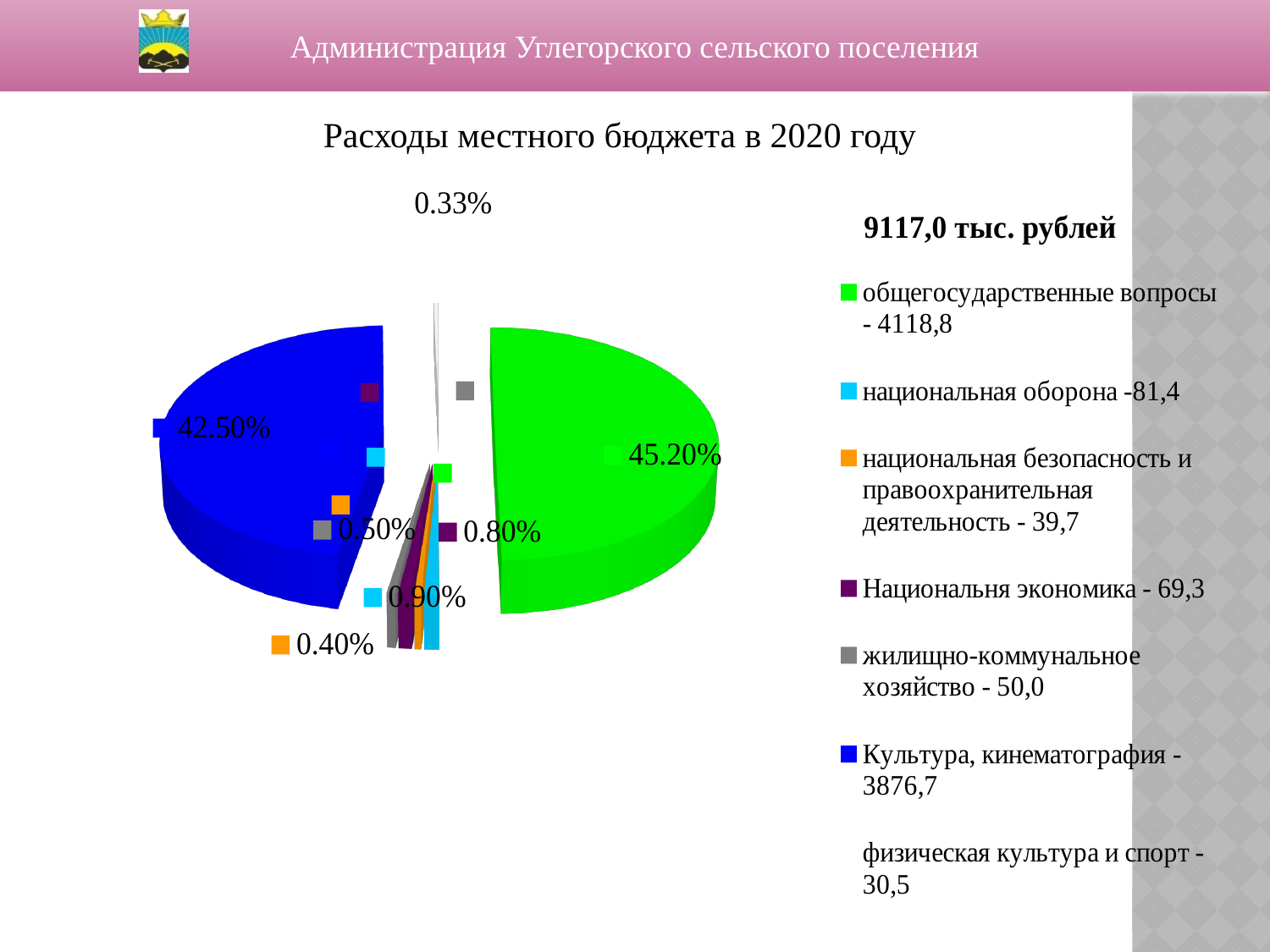
What share of the pie does национальная оборона have? 0.90% Which category has the smallest slice of the pie? физическая культура и спорт What is the difference in percentage points between the slices for общегосударственные вопросы and Культура, кинематография? 2.70% Which is larger: the slice for общегосударственные вопросы or the slice for Культура, кинематография? общегосударственные вопросы Which category has the largest slice of the pie? общегосударственные вопросы What share of the pie does физическая культура и спорт have? 0.33% How many categories does the legend of the pie chart list? 7 What amount does the legend give for жилищно-коммунальное хозяйство? 50,0 What share of the pie does общегосударственные вопросы have? 45.20% What share of the pie does Культура, кинематография have? 42.50% What kind of chart is shown on the slide? pie chart What total amount is shown next to the pie chart? 9117,0 тыс. рублей